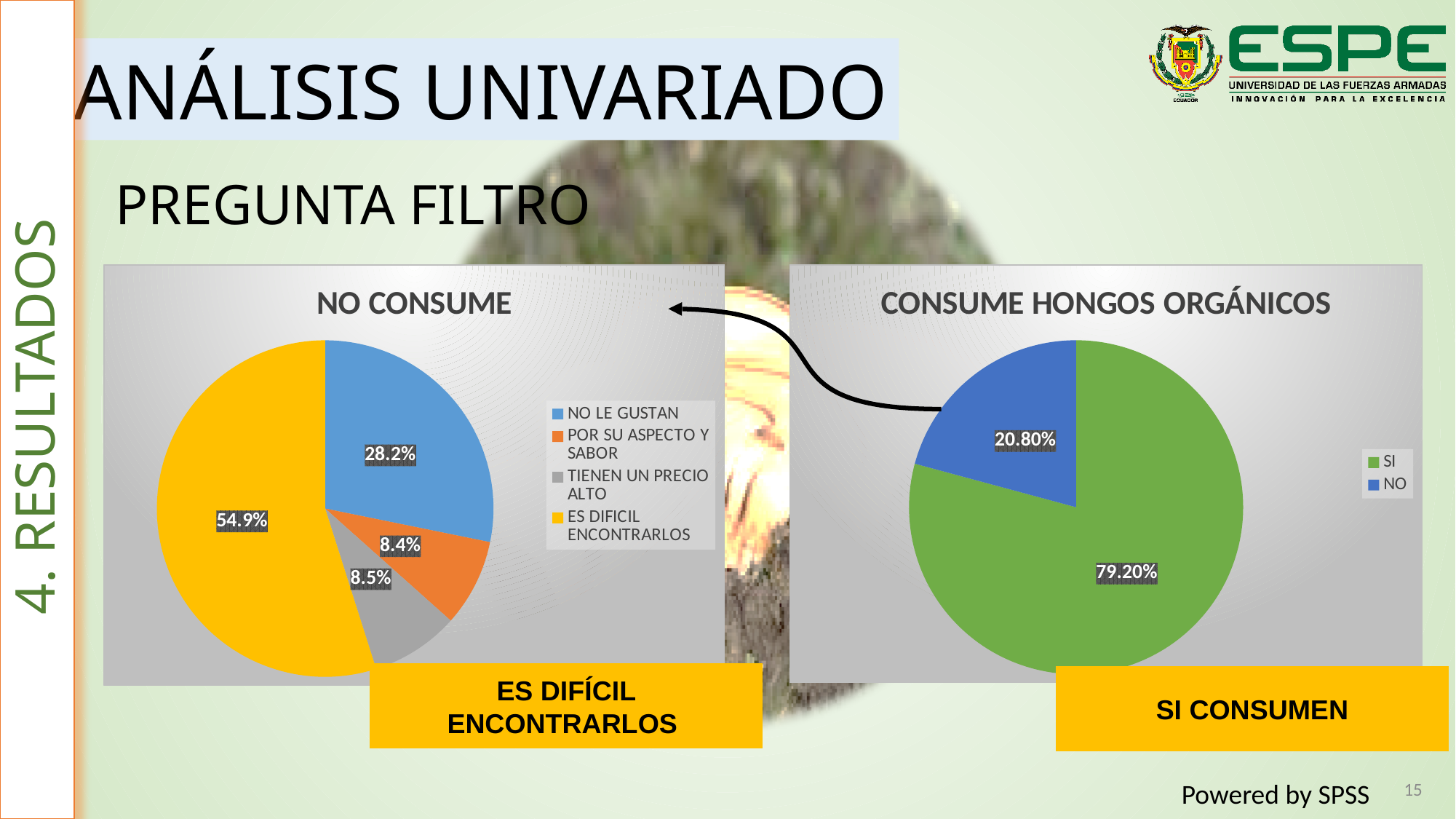
In the 'NO CONSUME' chart, what share is labelled for POR SU ASPECTO Y SABOR? 8.4% In the 'CONSUME HONGOS ORGÁNICOS' chart, which category is larger, SI or NO? SI In the 'NO CONSUME' chart, what share is labelled for NO LE GUSTAN? 28.2% In the 'NO CONSUME' chart, which category has the largest slice? ES DIFICIL ENCONTRARLOS In the 'NO CONSUME' chart, what share is labelled for TIENEN UN PRECIO ALTO? 8.5% In the 'CONSUME HONGOS ORGÁNICOS' chart, what share is labelled for NO? 20.80% What kind of chart is the 'CONSUME HONGOS ORGÁNICOS' chart? Pie chart In the 'CONSUME HONGOS ORGÁNICOS' chart, what share is labelled for SI? 79.20% In the 'CONSUME HONGOS ORGÁNICOS' chart, what colour is the SI slice? Green In the 'NO CONSUME' chart, what is the difference between the shares for ES DIFICIL ENCONTRARLOS and NO LE GUSTAN? 26.7% In the 'NO CONSUME' chart, how many categories does the legend list? 4 In the 'NO CONSUME' chart, what share is labelled for ES DIFICIL ENCONTRARLOS? 54.9%